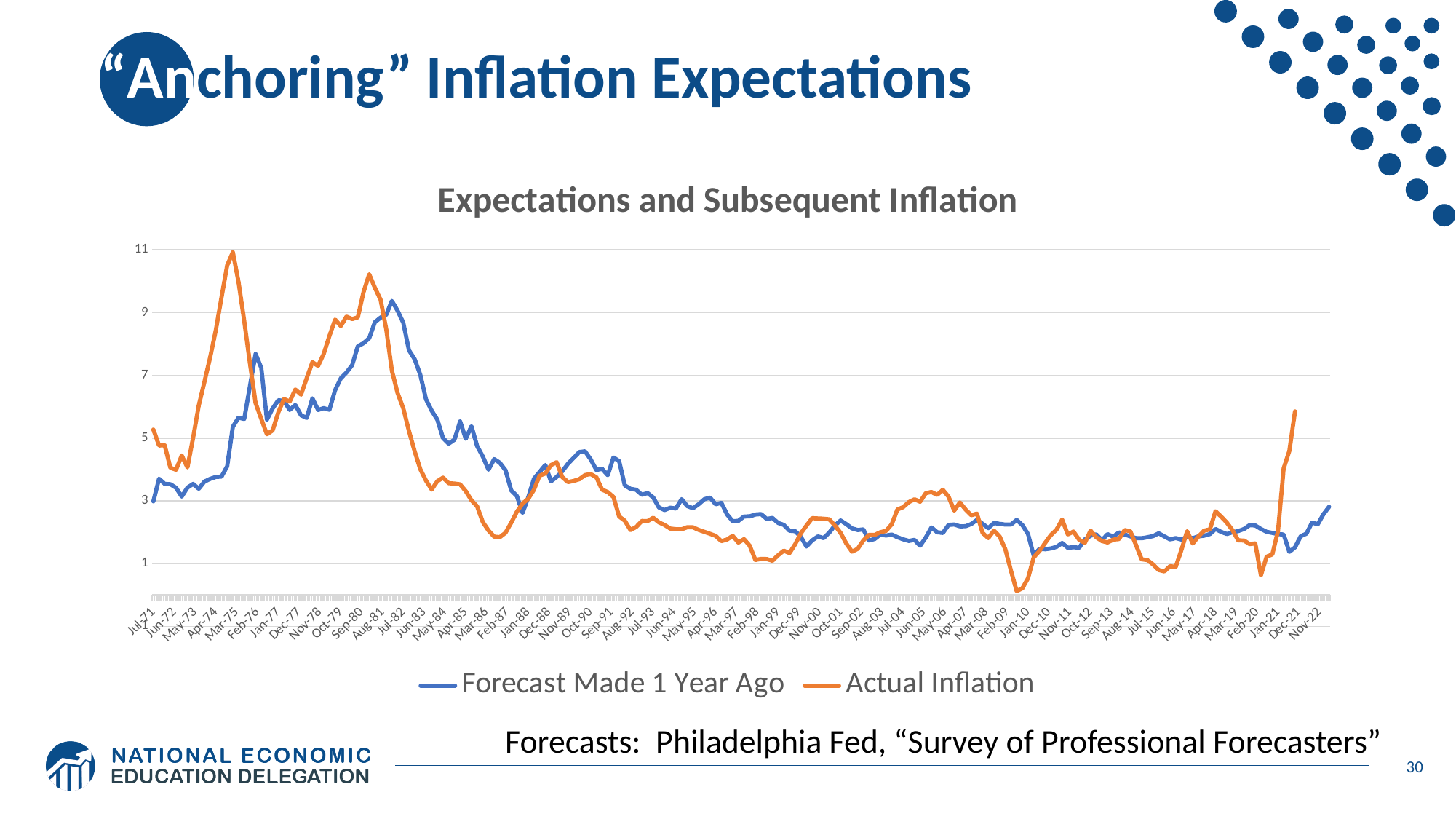
What is the title of the chart? Expectations and Subsequent Inflation Around Jan-10, which series has the higher value, Forecast Made 1 Year Ago or Actual Inflation? Forecast Made 1 Year Ago Is the peak value of Actual Inflation around Mar-75 greater or less than 9? greater Which series reaches the highest peak on the chart? Actual Inflation Which colour is used for the Actual Inflation series? Orange How many series does the legend list? 2 Does the Forecast Made 1 Year Ago series generally rise or fall between Jul-82 and Jan-99? Fall Around Mar-75, which series has the higher value, Forecast Made 1 Year Ago or Actual Inflation? Actual Inflation Is the lowest value of Actual Inflation around Jan-10 greater or less than 1? less Is the peak value of Forecast Made 1 Year Ago around Jul-82 greater or less than 7? greater What kind of chart is shown on the slide? Line chart